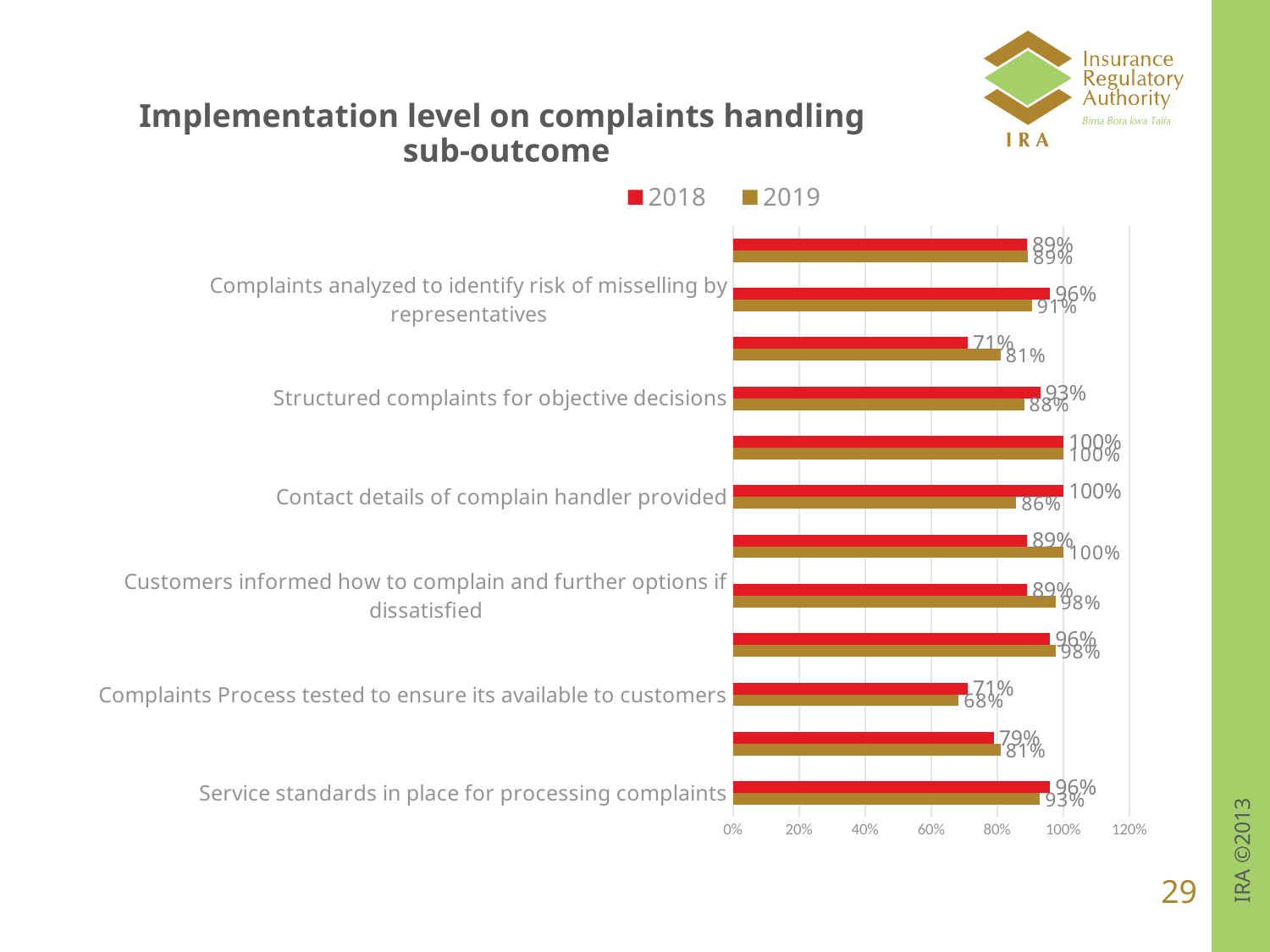
What is the difference between the 2018 and 2019 values for 'Contact details of complain handler provided'? 14% What is the 2019 value for 'Complaints Process tested to ensure its available to customers'? 68% For 'Customers informed how to complain and further options if dissatisfied', which year has the higher value, 2018 or 2019? 2019 Which years are listed in the legend? 2018 and 2019 What is the 2018 value for 'Complaints Process tested to ensure its available to customers'? 71% What is the 2018 value for 'Contact details of complain handler provided'? 100% Is the 2019 value for 'Complaints Process tested to ensure its available to customers' greater or less than 80%? less What is the 2019 value for 'Contact details of complain handler provided'? 86% How many series does the legend list? 2 For 'Service standards in place for processing complaints', which year has the higher value, 2018 or 2019? 2018 What is the 2019 value for 'Customers informed how to complain and further options if dissatisfied'? 98% What type of chart is shown on the slide? bar chart